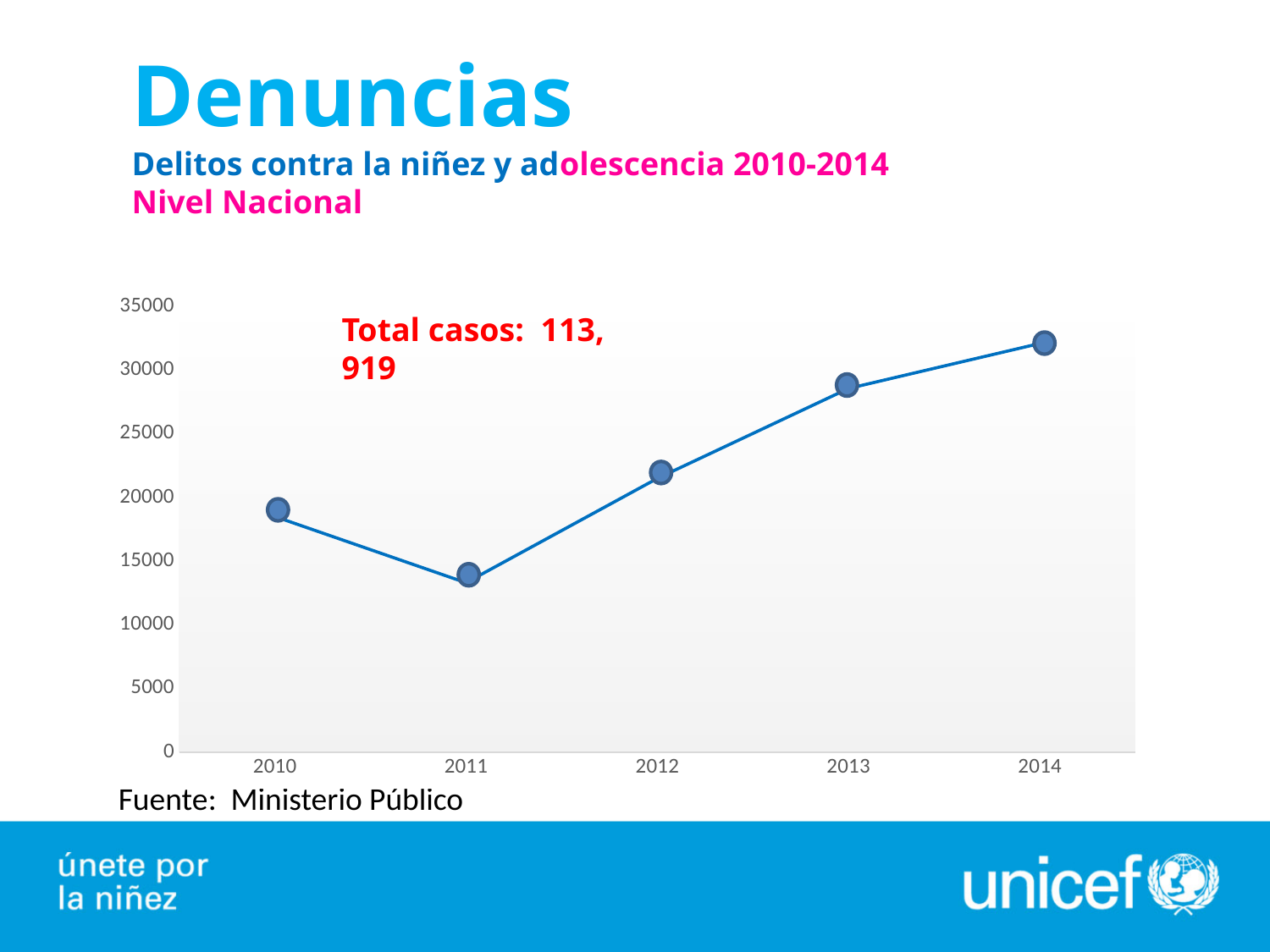
Which is larger, the value for 2010 or the value for 2011? 2010 What kind of chart is shown on the slide? line chart Is the value for 2012 greater or less than 20000? greater How many years are plotted on the x axis of the chart? 5 What source is cited below the chart? Ministerio Público Is the value for 2011 greater or less than 15000? less Which year has the highest value in the chart? 2014 Is the value for 2013 greater or less than 25000? greater What total number of cases is stated in the annotation on the chart? 113, 919 Do the values rise or fall from 2011 to 2014? rise Which year has the lowest value in the chart? 2011